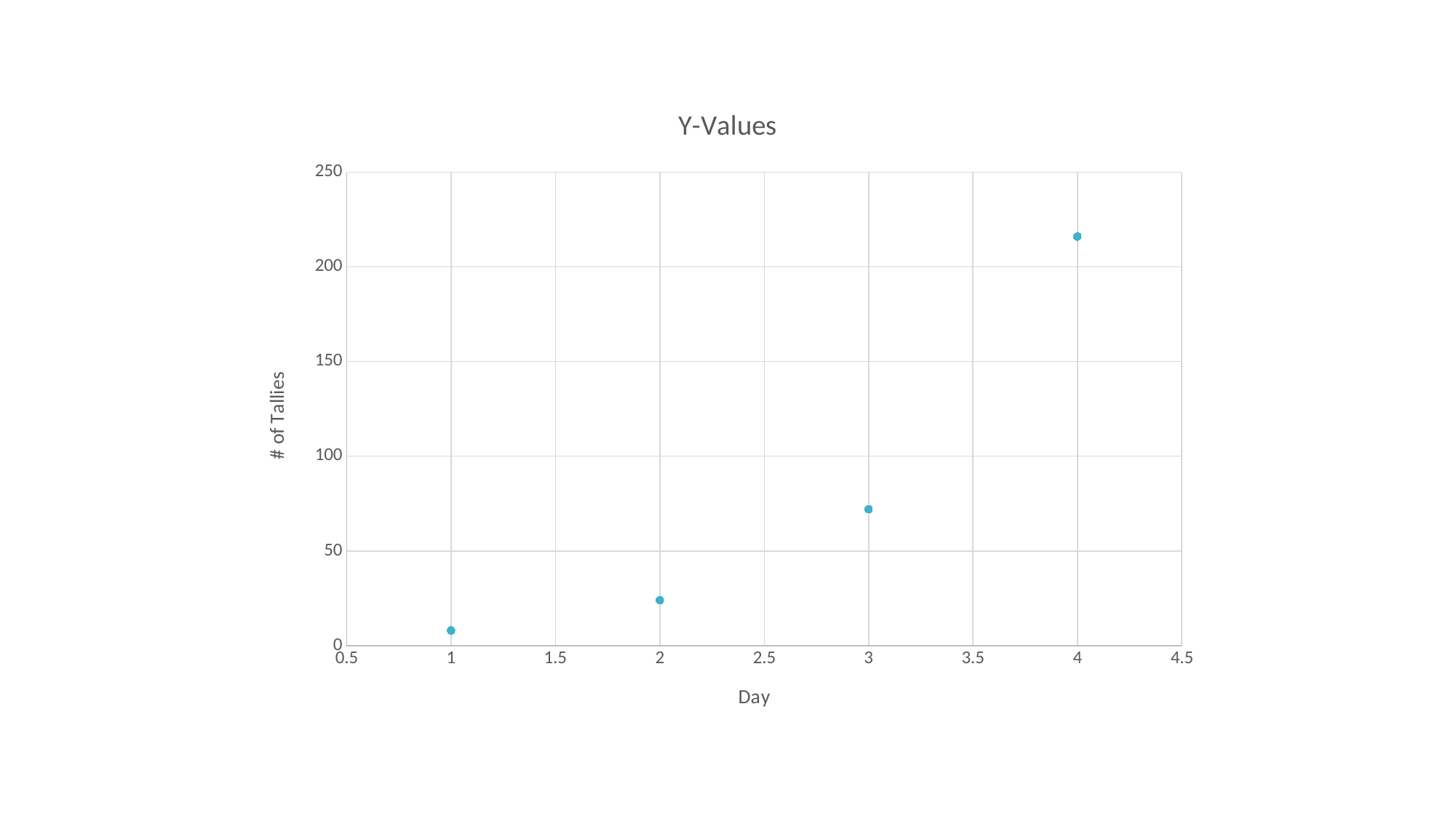
Is the value for day 2 greater or less than 50? less How many data points are plotted on the chart? 4 Which day has the highest number of tallies? 4 Is the value for day 4 greater or less than 200? greater Do the number of tallies rise or fall as the day increases? rise Is the value for day 3 greater or less than 100? less Which has more tallies, day 2 or day 3? day 3 What is the label of the y axis? # of Tallies What type of chart is shown on the slide? scatter chart What is the title of the chart? Y-Values Which day has the lowest number of tallies? 1